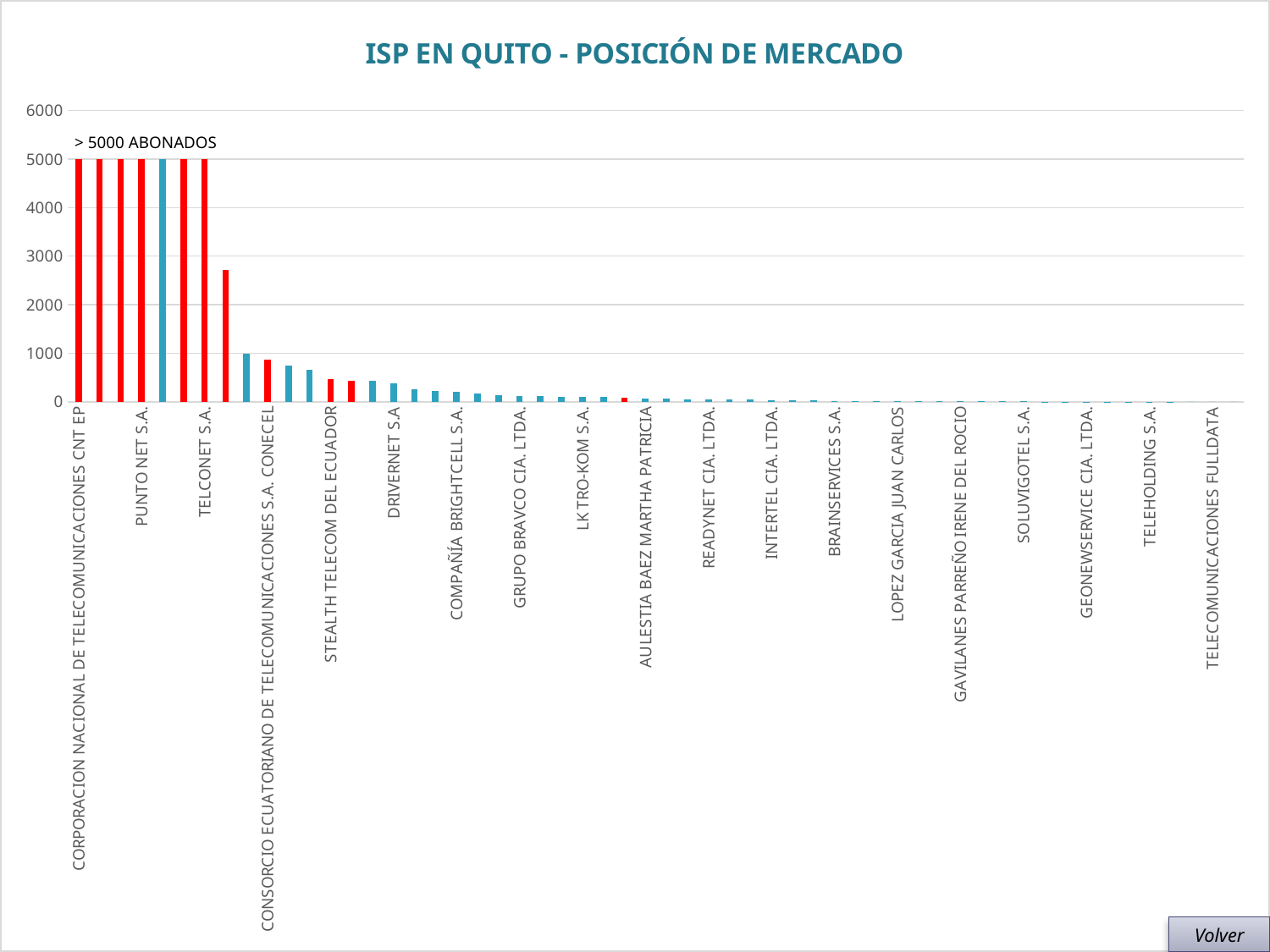
What annotation is written above the tallest bars at the left of the chart? > 5000 ABONADOS Is the value for DRIVERNET S.A greater or less than 1000? less Is the value for STEALTH TELECOM DEL ECUADOR greater or less than 1000? less What is the highest value shown on the vertical axis? 6000 What is the title of the chart? ISP EN QUITO - POSICIÓN DE MERCADO Which has a larger value, PUNTO NET S.A. or STEALTH TELECOM DEL ECUADOR? PUNTO NET S.A. Is the value for CONSORCIO ECUATORIANO DE TELECOMUNICACIONES S.A. CONECEL greater or less than 2000? less What kind of chart is shown on the slide? Bar chart Do the bar values rise or fall from left to right along the x axis? Fall Which has a larger value, CONSORCIO ECUATORIANO DE TELECOMUNICACIONES S.A. CONECEL or DRIVERNET S.A? CONSORCIO ECUATORIANO DE TELECOMUNICACIONES S.A. CONECEL